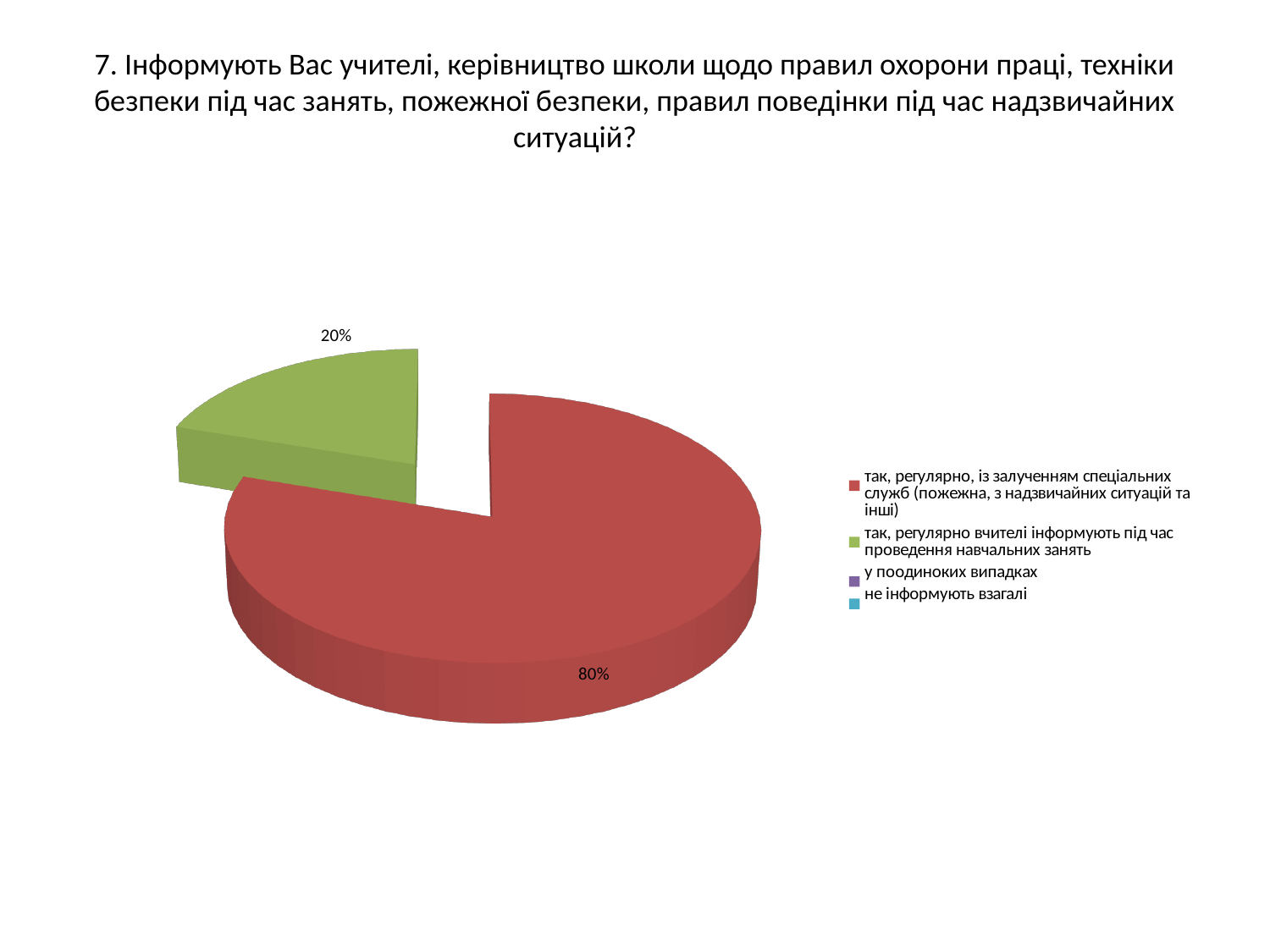
How many slices are visible in the pie? 2 What is the total of the two labelled slices? 100% What colour is the slice labelled 80%? red What share of the pie does the slice for "так, регулярно, із залученням спеціальних служб (пожежна, з надзвичайних ситуацій та інші)" represent? 80% How many entries does the legend list? 4 Is the share for "так, регулярно вчителі інформують під час проведення навчальних занять" greater or less than 50%? less Which category has the largest slice of the pie? так, регулярно, із залученням спеціальних служб (пожежна, з надзвичайних ситуацій та інші) What kind of chart is shown on the slide? pie chart What is the difference in percentage points between the 80% slice and the 20% slice? 60 What share of the pie does the slice for "так, регулярно вчителі інформують під час проведення навчальних занять" represent? 20% Which of the two visible slices is smaller, the red one or the green one? the green one Which legend entry is shown in green? так, регулярно вчителі інформують під час проведення навчальних занять